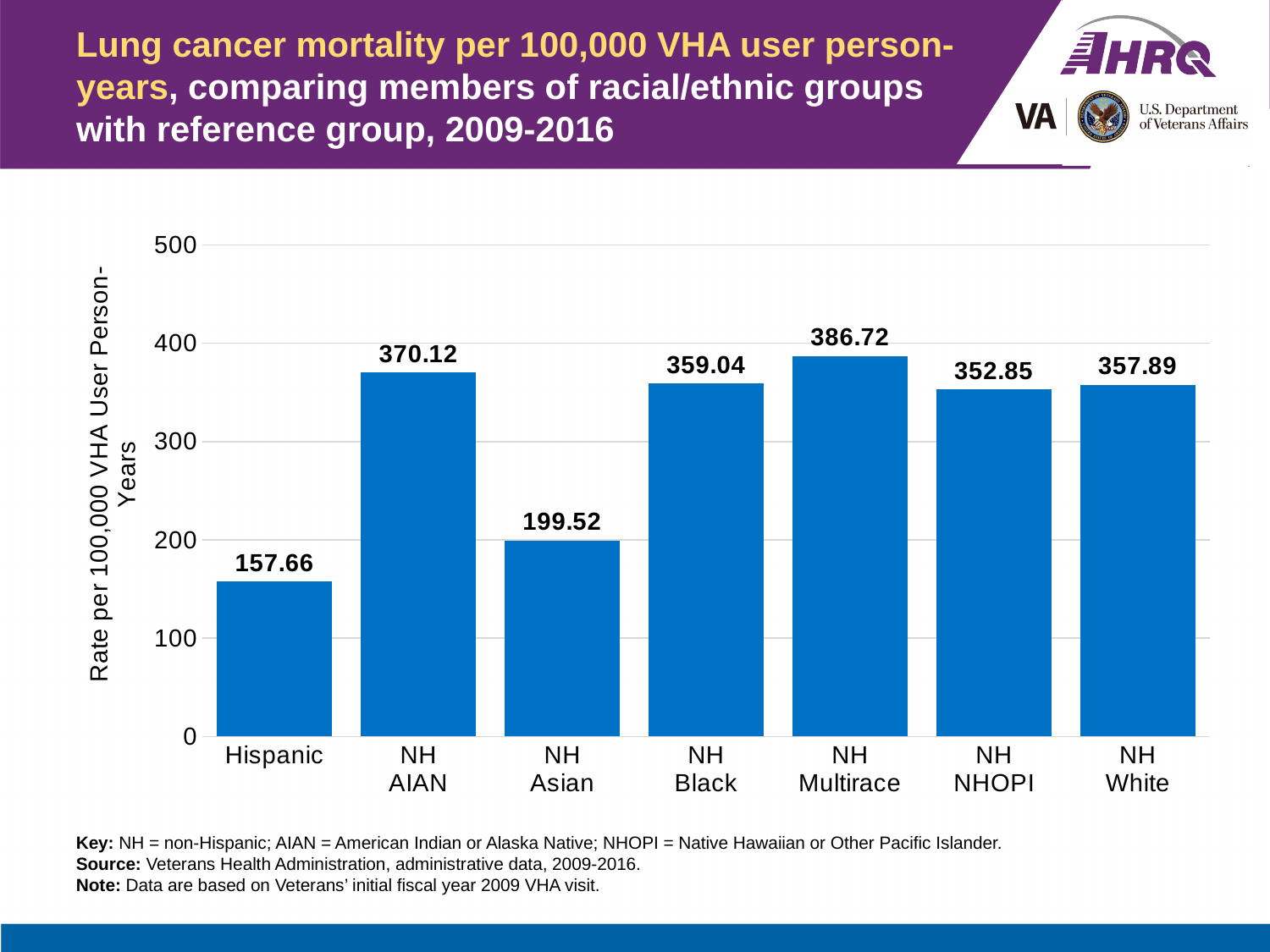
What is the lung cancer mortality rate for Hispanic VHA users? 157.66 Which racial/ethnic group has the lowest lung cancer mortality rate? Hispanic What is the lung cancer mortality rate for NH Asian VHA users? 199.52 How many racial/ethnic groups are shown in the chart? 7 What kind of chart is shown on the slide? Bar chart What is the difference between the lung cancer mortality rates for NH Multirace and NH White VHA users? 28.83 Which racial/ethnic group has the highest lung cancer mortality rate? NH Multirace What is the label of the vertical axis? Rate per 100,000 VHA User Person-Years What is the lung cancer mortality rate for NH Multirace VHA users? 386.72 What is the difference between the lung cancer mortality rates for NH AIAN and Hispanic VHA users? 212.46 Which has a higher lung cancer mortality rate, NH AIAN or NH Black? NH AIAN Is the lung cancer mortality rate for NH Asian VHA users greater or less than 200? less